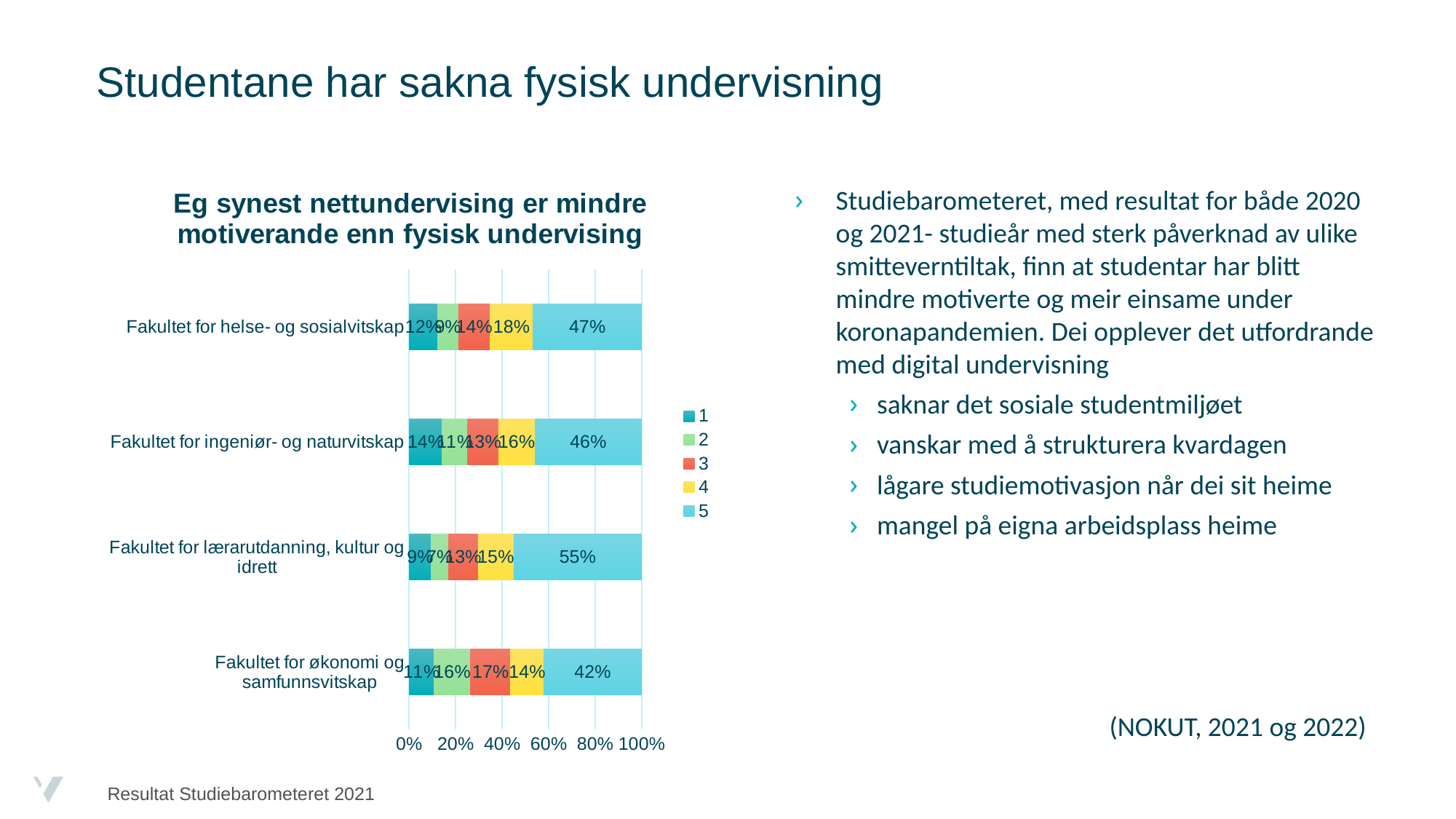
What is the difference in percentage points between the series 5 values for Fakultet for lærarutdanning, kultur og idrett and Fakultet for økonomi og samfunnsvitskap? 13 percentage points What is the value of series 3 for Fakultet for økonomi og samfunnsvitskap? 17% What is the value of series 5 for Fakultet for helse- og sosialvitskap? 47% How many series does the chart legend list? 5 What is the value of series 1 for Fakultet for ingeniør- og naturvitskap? 14% How many faculties (categories) are shown in the chart? 4 What is the title of the chart? Eg synest nettundervising er mindre motiverande enn fysisk undervising What kind of chart is shown on the slide? Stacked bar chart Which faculty has the highest value for series 5? Fakultet for lærarutdanning, kultur og idrett Which faculty has the lowest value for series 5? Fakultet for økonomi og samfunnsvitskap What is the value of series 5 for Fakultet for lærarutdanning, kultur og idrett? 55% Which is larger: the series 5 value for Fakultet for lærarutdanning, kultur og idrett or for Fakultet for økonomi og samfunnsvitskap? Fakultet for lærarutdanning, kultur og idrett